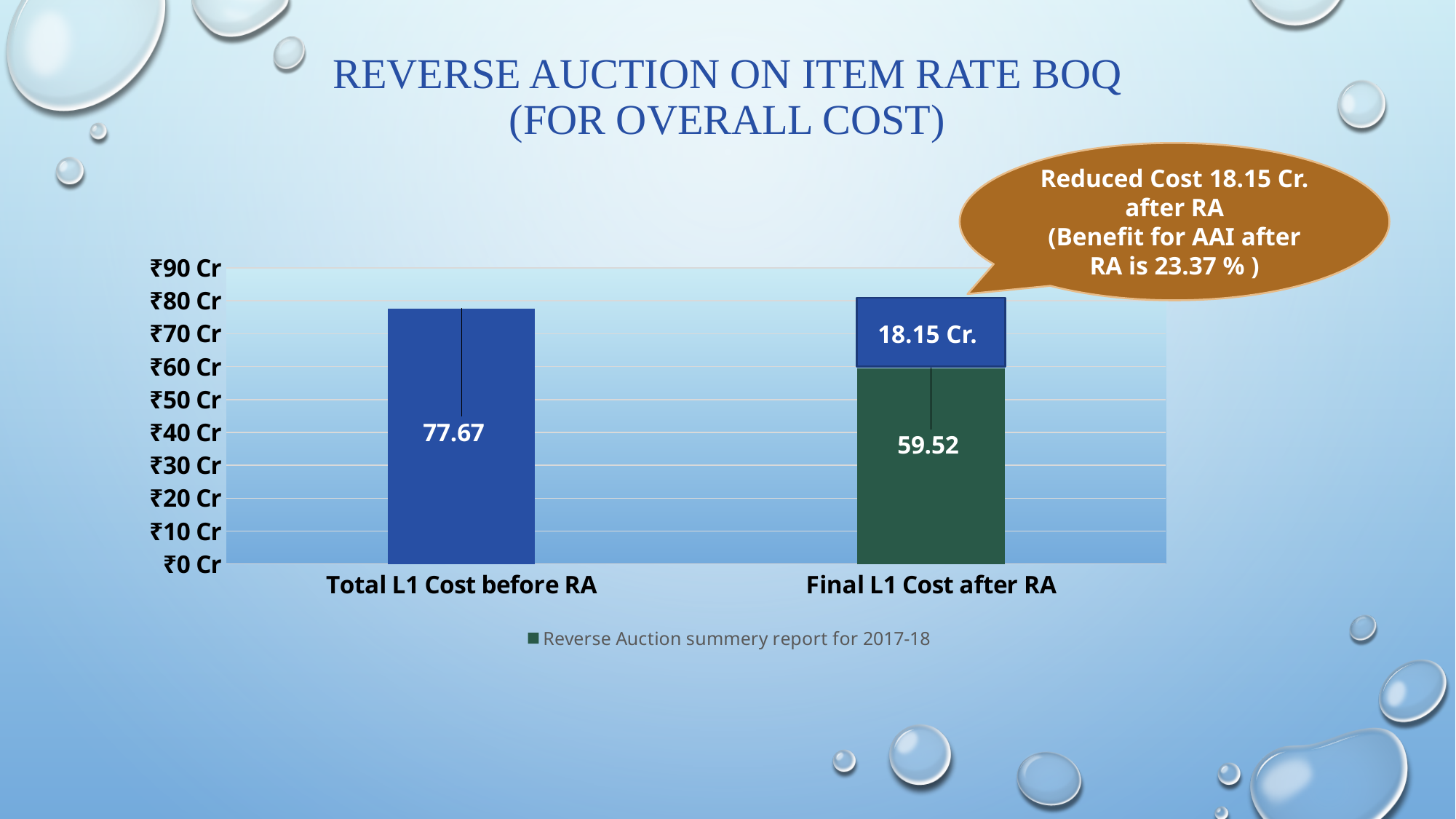
How many entries does the chart legend list? 1 What is the value shown on the green bar for Final L1 Cost after RA? 59.52 Is the green bar value for Final L1 Cost after RA greater or less than ₹60 Cr? less What kind of chart is shown on the slide? Bar chart How many categories are shown on the x axis of the chart? 2 Which category has the lower green/base bar value, Total L1 Cost before RA or Final L1 Cost after RA? Final L1 Cost after RA What is the value shown for Total L1 Cost before RA? 77.67 What is the legend entry shown below the chart? Reverse Auction summery report for 2017-18 What is the difference between the Total L1 Cost before RA (77.67) and the Final L1 Cost after RA (59.52)? 18.15 What value is labelled on the blue segment stacked on top of the Final L1 Cost after RA bar? 18.15 Cr. Is the value for Total L1 Cost before RA greater or less than ₹70 Cr? greater Which is larger, the value for Total L1 Cost before RA or the green bar value for Final L1 Cost after RA? Total L1 Cost before RA